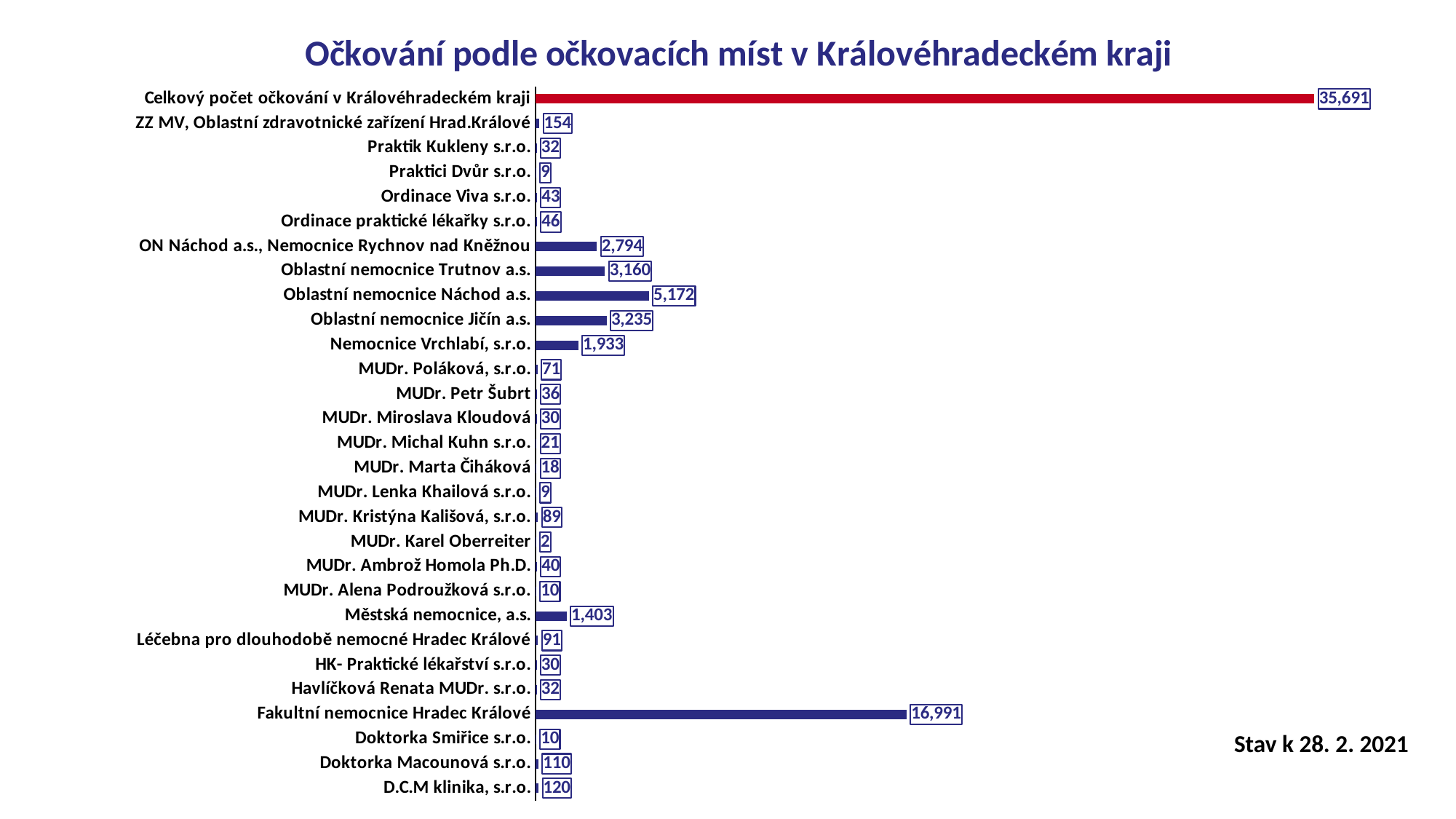
What type of chart is shown on the slide? bar chart What is the value for Oblastní nemocnice Náchod a.s.? 5,172 What is the title of the chart? Očkování podle očkovacích míst v Královéhradeckém kraji What is the value for Městská nemocnice, a.s.? 1,403 What is the difference between the values for Fakultní nemocnice Hradec Králové and Oblastní nemocnice Náchod a.s.? 11,819 Which is larger, the value for Oblastní nemocnice Trutnov a.s. or the value for ON Náchod a.s., Nemocnice Rychnov nad Kněžnou? Oblastní nemocnice Trutnov a.s. Which category has the highest value? Celkový počet očkování v Královéhradeckém kraji Which category has the lowest value? MUDr. Karel Oberreiter What is the difference between the values for Oblastní nemocnice Náchod a.s. and Oblastní nemocnice Jičín a.s.? 1,937 What is the value for Celkový počet očkování v Královéhradeckém kraji? 35,691 How many categories are shown in the chart? 29 What is the value for Fakultní nemocnice Hradec Králové? 16,991